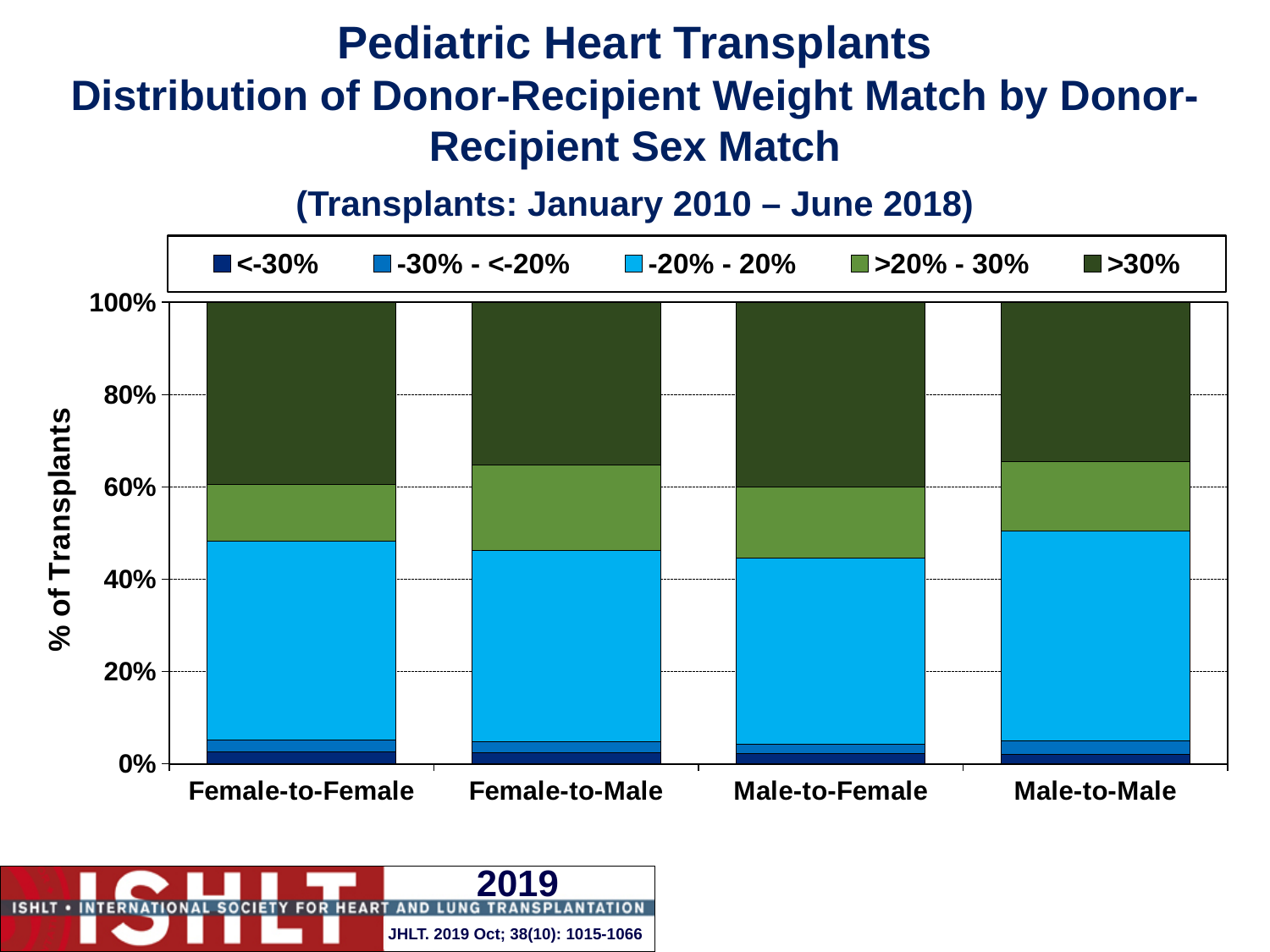
Is the cumulative top of the -20% - 20% segment for Male-to-Male greater or less than 40%? greater Is the cumulative top of the >20% - 30% segment for Male-to-Male greater or less than 80%? less What is the total height of each stacked bar? 100% Which has the larger >30% segment, Male-to-Female or Male-to-Male? Male-to-Female How many donor-recipient sex match categories are shown on the x axis? 4 Is the cumulative top of the -20% - 20% segment for Male-to-Female greater or less than 60%? less How many series does the legend list? 5 What time period of transplants does the chart cover, according to the subtitle? January 2010 – June 2018 What is the label of the y axis? % of Transplants What kind of chart is shown on the slide? Stacked bar chart